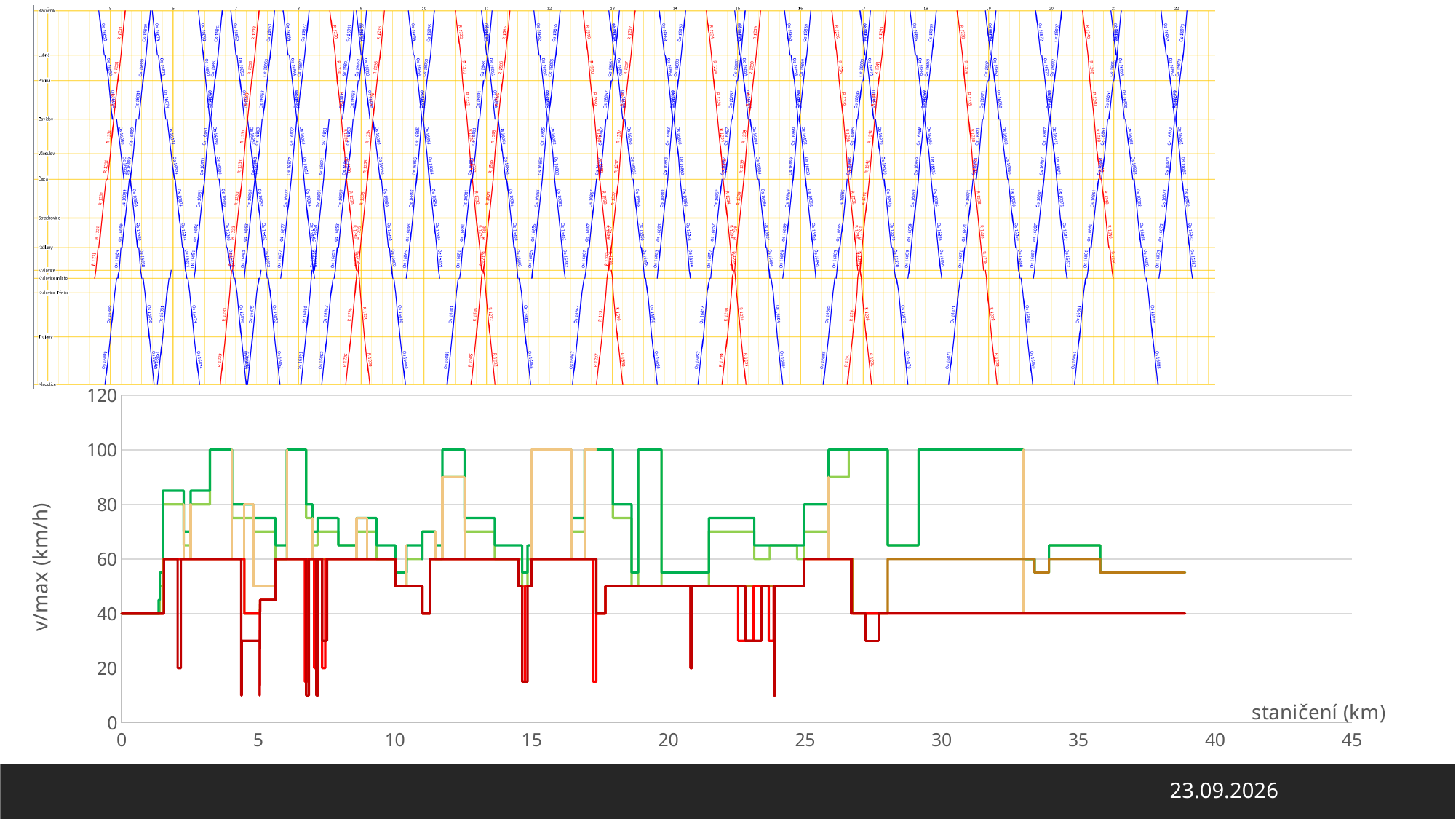
In the bottom chart, is the value of the red line at 0 km greater or less than 60? less In the bottom chart, is the value of the green line at 31 km greater or less than 80? greater In the bottom chart, is the value of the red line at 30 km greater or less than 60? less What is the label on the vertical axis of the bottom chart? v/max (km/h) What is the label on the horizontal axis of the bottom chart? staničení (km) What kind of chart is the top chart on the slide? line chart What kind of chart is the bottom chart on the slide? line chart